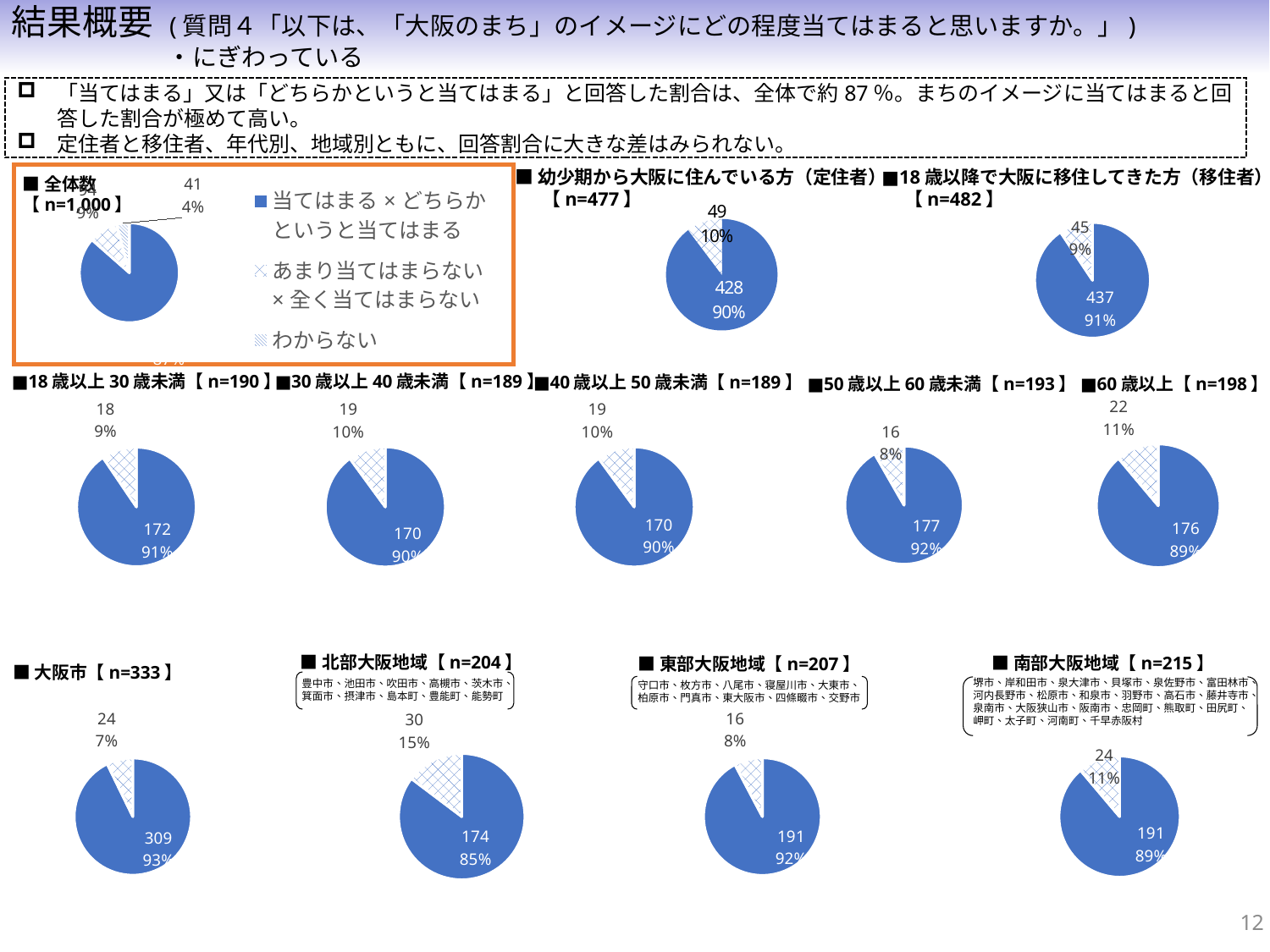
What type of chart is used throughout this slide? Pie chart What is the sample size (n) shown for the 東部大阪地域 chart? 207 In the 18歳以降で大阪に移住してきた方（移住者） chart, how many respondents are in the 当てはまる × どちらかというと当てはまる slice? 437 How many entries does the legend next to the 全体数 chart list? 3 In the 大阪市 chart, what percentage is shown for the あまり当てはまらない × 全く当てはまらない slice? 7% In the 南部大阪地域 chart, what count is shown for the 当てはまる × どちらかというと当てはまる slice? 191 Which chart shows a larger percentage for the 当てはまる × どちらかというと当てはまる slice: 大阪市 or 北部大阪地域? 大阪市 In the 幼少期から大阪に住んでいる方（定住者） chart, what percentage is shown for the 当てはまる × どちらかというと当てはまる slice? 90% In the 60歳以上 chart, what percentage is shown for the あまり当てはまらない × 全く当てはまらない slice? 11% What is the difference in percentage points between the 当てはまる × どちらかというと当てはまる slice in the 大阪市 chart and in the 北部大阪地域 chart? 8 In the 50歳以上60歳未満 chart, what is the difference between the counts of the two labelled slices? 161 In the 北部大阪地域 chart, what count is shown for the あまり当てはまらない × 全く当てはまらない slice? 30